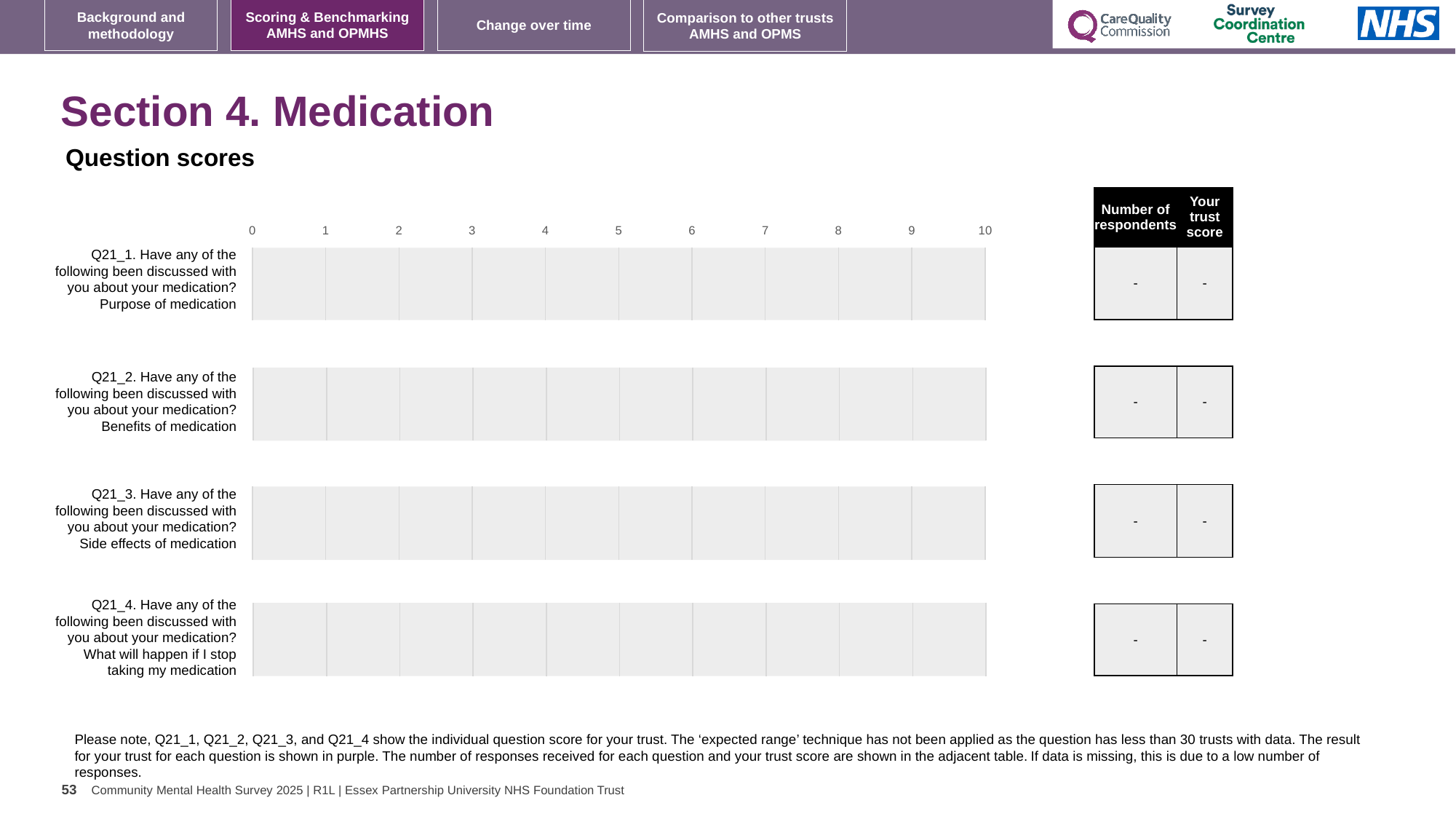
What kind of chart is used to show the question scores on this slide? bar chart What is the lowest value shown on the chart's x axis? 0 What is shown in the 'Number of respondents' column for Q21_4 (What will happen if I stop taking my medication)? - What is shown in the 'Your trust score' column for Q21_2 (Benefits of medication)? - What is shown in the 'Your trust score' column for Q21_3 (Side effects of medication)? - What is shown in the 'Number of respondents' column for Q21_1 (Purpose of medication)? - How many questions (categories) are listed on the chart? 4 What is the highest value shown on the chart's x axis? 10